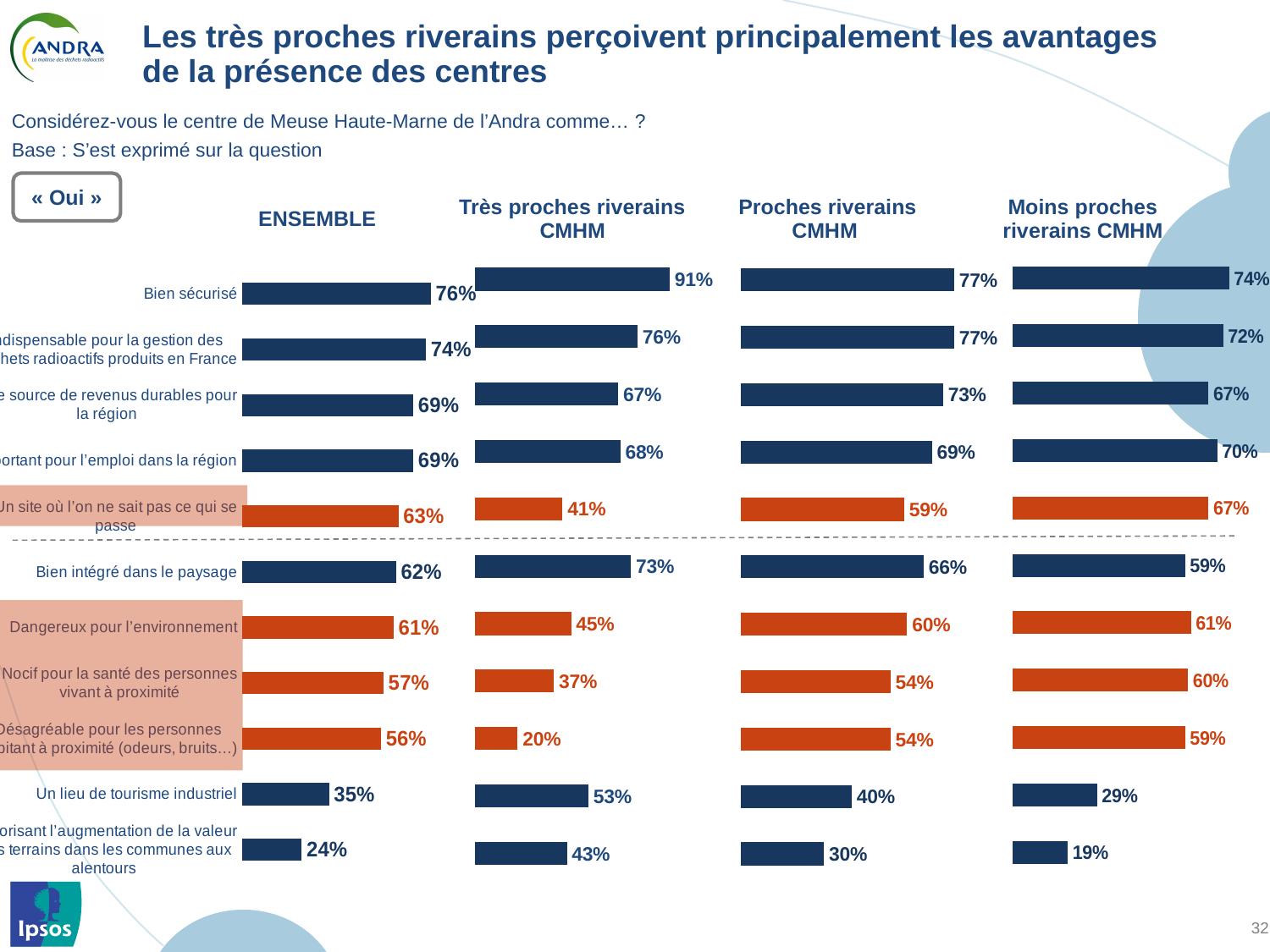
Which is larger: "Un site où l'on ne sait pas ce qui se passe" in the "Très proches riverains CMHM" chart or in the "Moins proches riverains CMHM" chart? Moins proches riverains CMHM In the "Proches riverains CMHM" chart, what is the value for "Un lieu de tourisme industriel"? 40% In the "Très proches riverains CMHM" chart, what is the value for "Bien sécurisé"? 91% In the ENSEMBLE chart, what is the value for "Bien sécurisé"? 76% What type of chart is used for the ENSEMBLE data? Bar chart In the ENSEMBLE chart, which category has the lowest value? Favorisant l'augmentation de la valeur des terrains dans les communes aux alentours In the "Moins proches riverains CMHM" chart, what is the value for "Dangereux pour l'environnement"? 61% In the "Très proches riverains CMHM" chart, what is the difference between "Bien intégré dans le paysage" and "Dangereux pour l'environnement"? 28% In the "Très proches riverains CMHM" chart, which category has the lowest value? Désagréable pour les personnes habitant à proximité (odeurs, bruits…) In the "Très proches riverains CMHM" chart, which category has the highest value? Bien sécurisé What is the difference between the "Bien sécurisé" values in the "Très proches riverains CMHM" chart and the ENSEMBLE chart? 15% How many categories are shown in the ENSEMBLE chart? 11